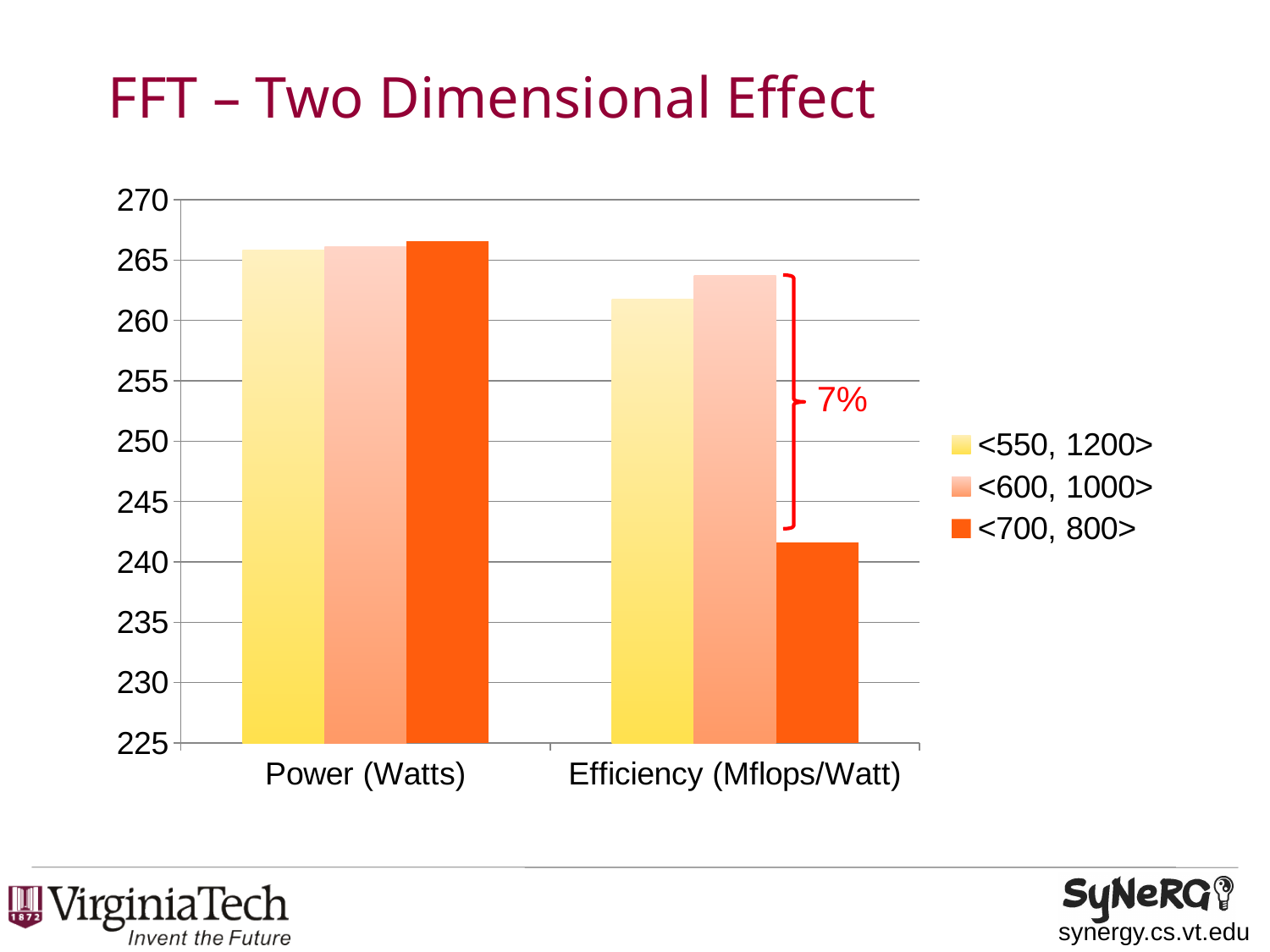
Which series has the highest value for Efficiency (Mflops/Watt)? <600, 1000> Is the Efficiency (Mflops/Watt) value for <600, 1000> greater or less than 260? greater How many categories are shown on the x axis? 2 How many series does the legend list? 3 Is the Efficiency (Mflops/Watt) value for <700, 800> greater or less than 245? less For Efficiency (Mflops/Watt), which is larger: <600, 1000> or <700, 800>? <600, 1000> What is the title of the slide containing the chart? FFT – Two Dimensional Effect Is the Efficiency (Mflops/Watt) value for <700, 800> greater or less than 240? greater What kind of chart is shown on the slide? bar chart Which series has the lowest value for Efficiency (Mflops/Watt)? <700, 800> What percentage is shown by the red bracket annotation on the Efficiency (Mflops/Watt) bars? 7%